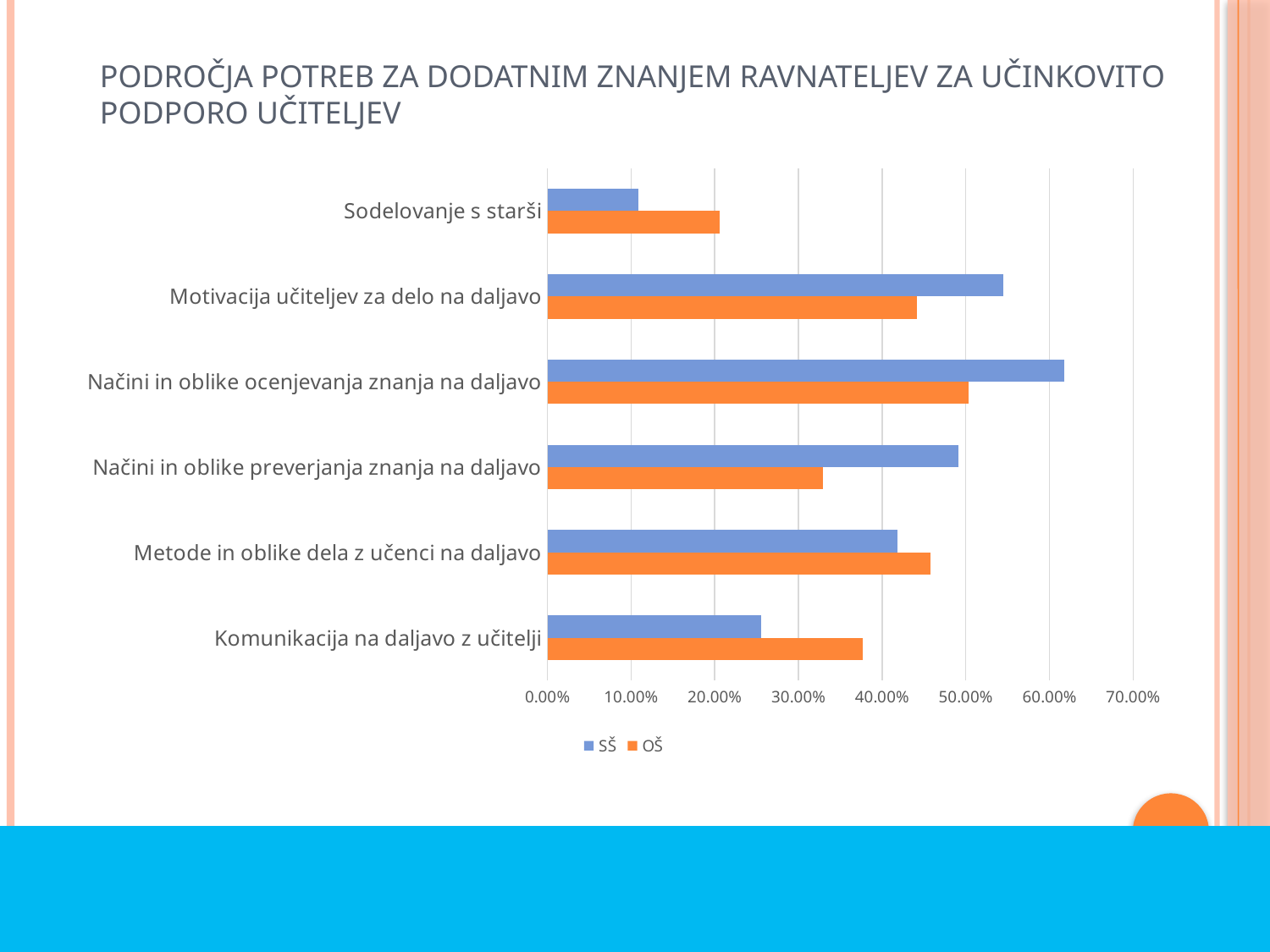
Is the OŠ value for Motivacija učiteljev za delo na daljavo greater or less than 40.00%? greater Which category has the lowest value for the OŠ series? Sodelovanje s starši Which category has the highest value for the SŠ series? Načini in oblike ocenjevanja znanja na daljavo Is the SŠ value for Načini in oblike ocenjevanja znanja na daljavo greater or less than 50.00%? greater Is the OŠ value for Komunikacija na daljavo z učitelji greater or less than 40.00%? less For Načini in oblike preverjanja znanja na daljavo, which series has the larger value, SŠ or OŠ? SŠ Which category has the lowest value for the SŠ series? Sodelovanje s starši What kind of chart is shown on the slide? bar chart For Komunikacija na daljavo z učitelji, which series has the larger value, SŠ or OŠ? OŠ How many series does the legend list? 2 How many categories are shown on the chart? 6